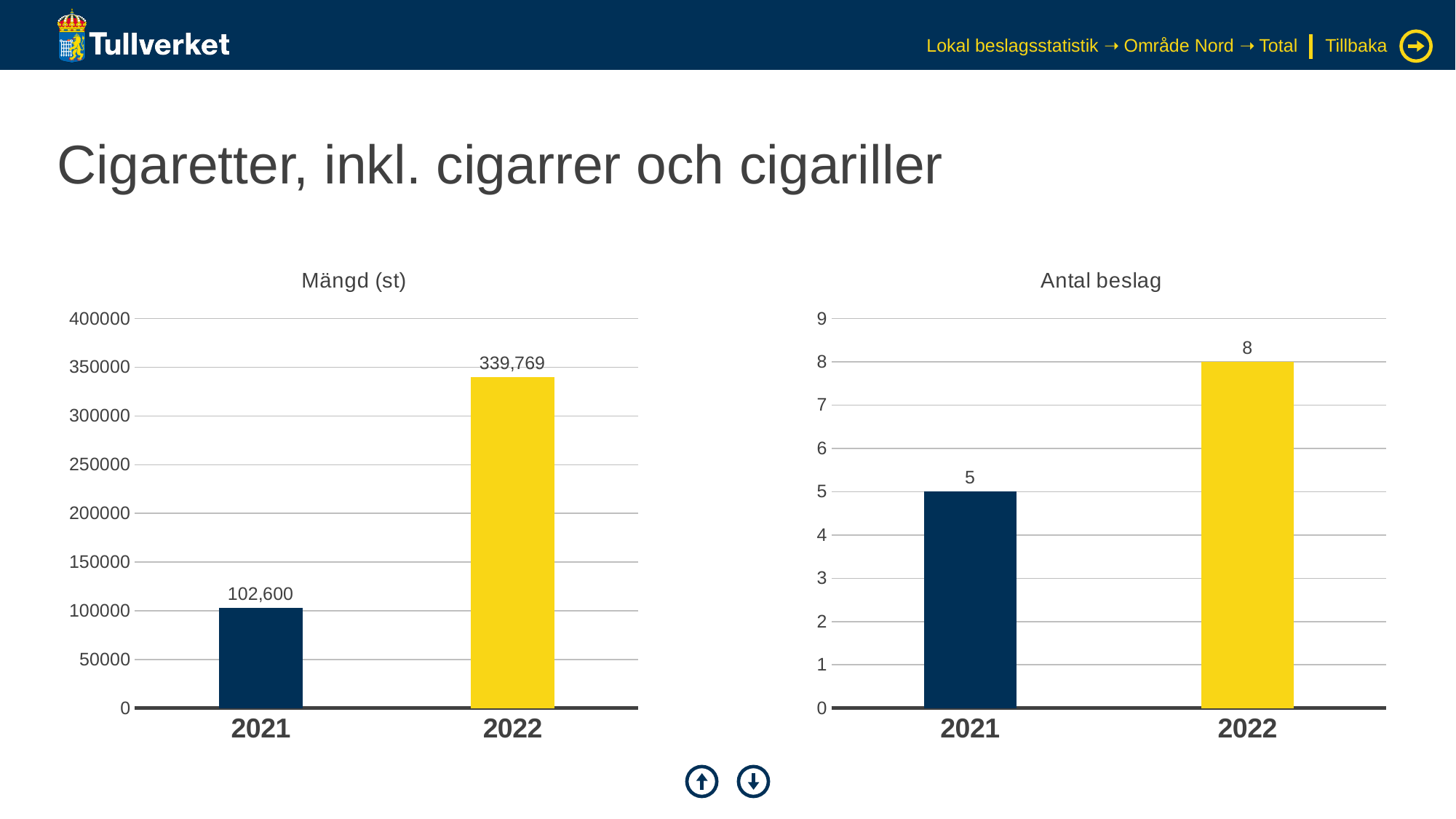
In the "Mängd (st)" chart, how many years are shown on the x axis? 2 In the "Mängd (st)" chart, what is the value for 2021? 102,600 In the "Antal beslag" chart, which year has the lowest value? 2021 What kind of chart is the "Antal beslag" chart? bar chart In the "Antal beslag" chart, what is the difference between the 2022 and 2021 values? 3 In the "Mängd (st)" chart, what is the difference between the 2022 and 2021 values? 237,169 In the "Antal beslag" chart, which is larger, the value for 2021 or 2022? 2022 In the "Antal beslag" chart, what is the value for 2022? 8 In the "Mängd (st)" chart, what is the value for 2022? 339,769 In the "Antal beslag" chart, what is the value for 2021? 5 In the "Mängd (st)" chart, which year has the highest value? 2022 In the "Mängd (st)" chart, do the values rise or fall from 2021 to 2022? rise